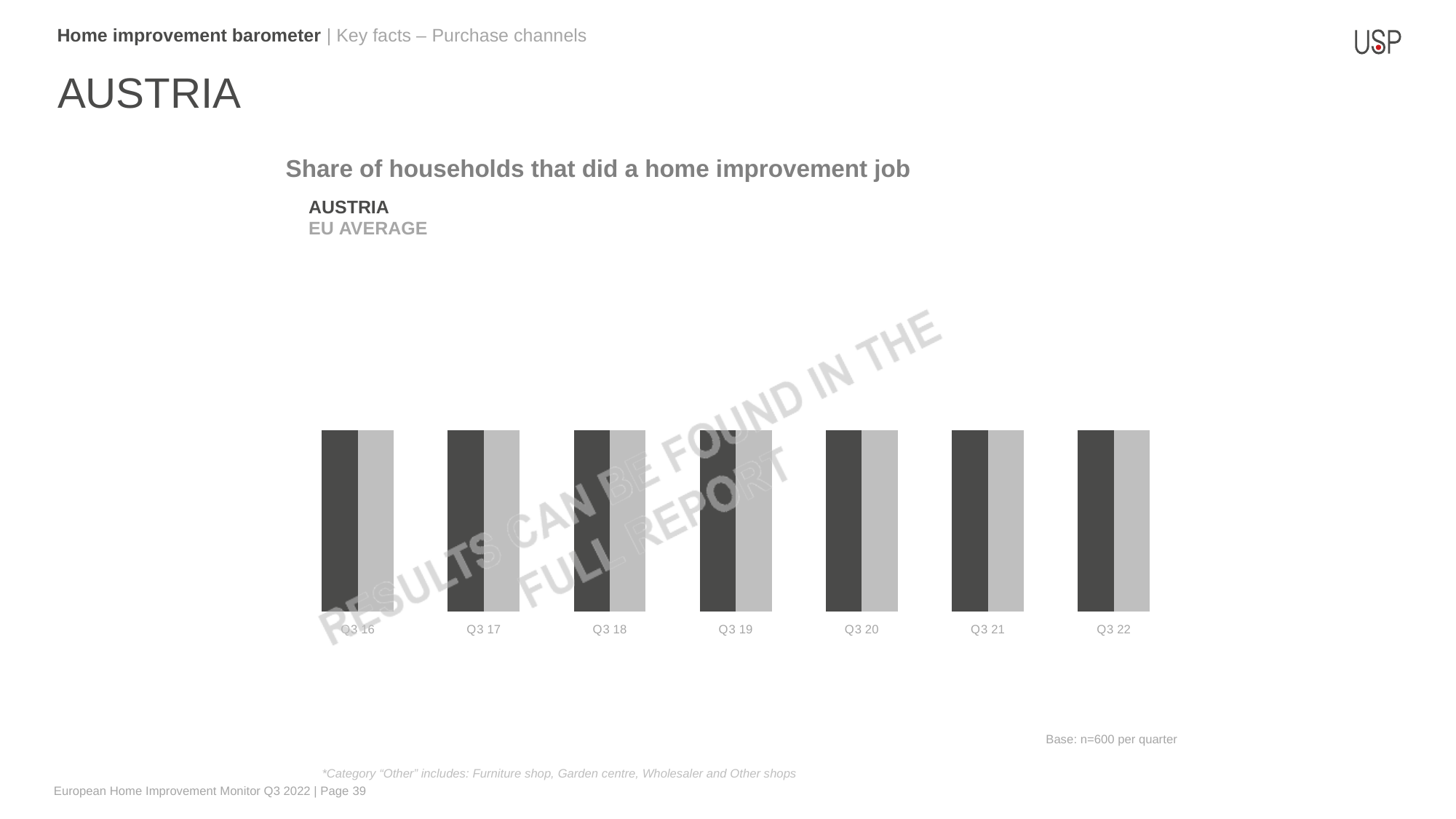
Do the bar heights rise, fall, or stay the same from Q3 16 to Q3 22? Stay the same What is the last quarter shown on the x axis of the chart? Q3 22 What kind of chart is shown on the slide? Bar chart How many series does the chart's legend list? 2 How many quarters are shown along the x axis of the chart? 7 What is the first quarter shown on the x axis of the chart? Q3 16 What is the title of the chart? Share of households that did a home improvement job Which two series are listed in the chart's legend? AUSTRIA and EU AVERAGE